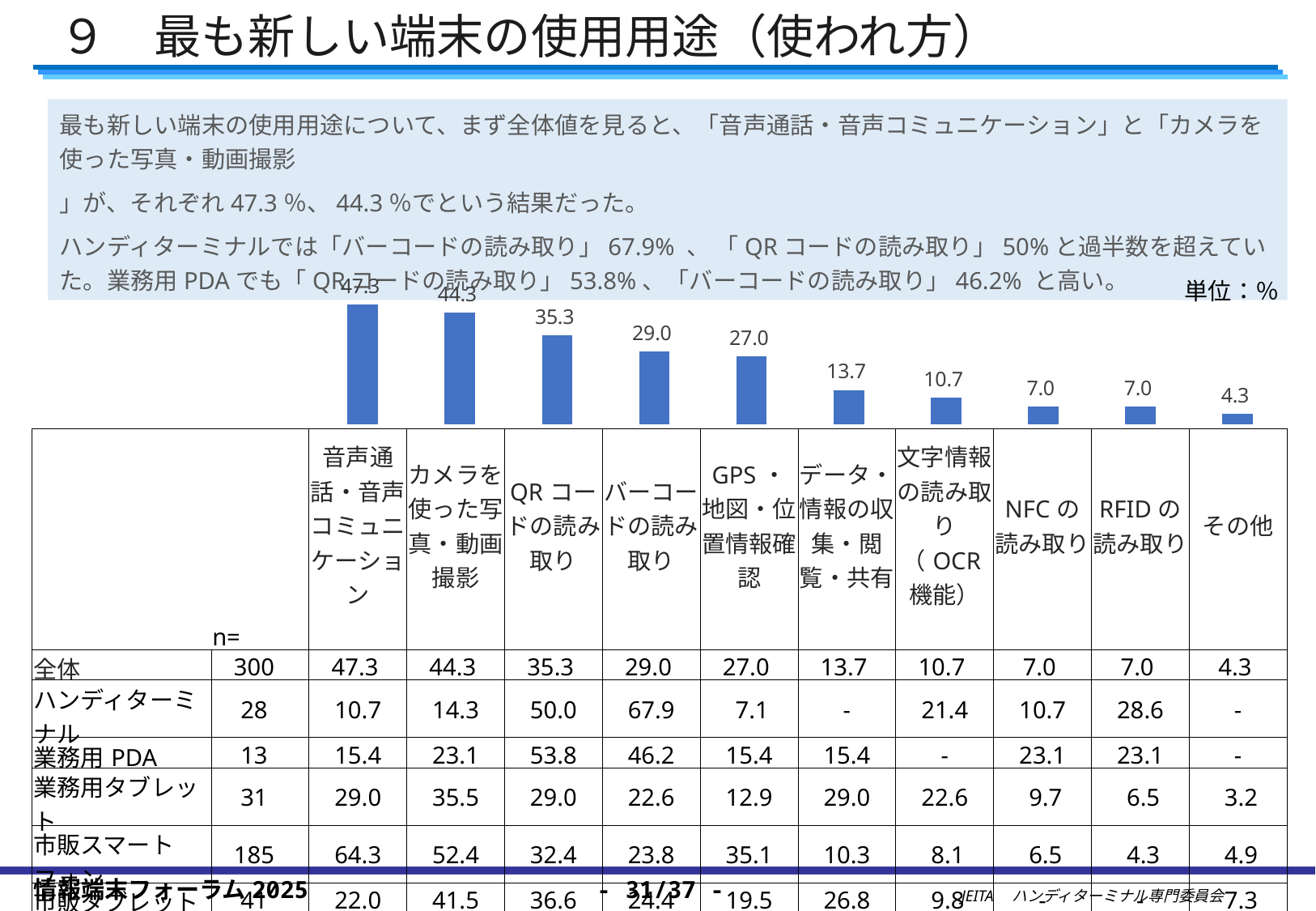
Do the bar values rise or fall from left to right across the chart? fall What is the value of the bar for 音声通話・音声コミュニケーション? 47.3 What type of chart is shown on the slide? bar chart What is the value of the bar for GPS・地図・位置情報確認? 27.0 Which is larger, the bar for バーコードの読み取り or the bar for GPS・地図・位置情報確認? バーコードの読み取り What is the difference between the bars for 音声通話・音声コミュニケーション and カメラを使った写真・動画撮影? 3.0 How many bars are plotted in the chart? 10 Which category has the highest bar in the chart? 音声通話・音声コミュニケーション Which category has the lowest bar in the chart? その他 What is the value of the bar for QRコードの読み取り? 35.3 What is the value of the bar for その他? 4.3 What unit is indicated for the chart values? %